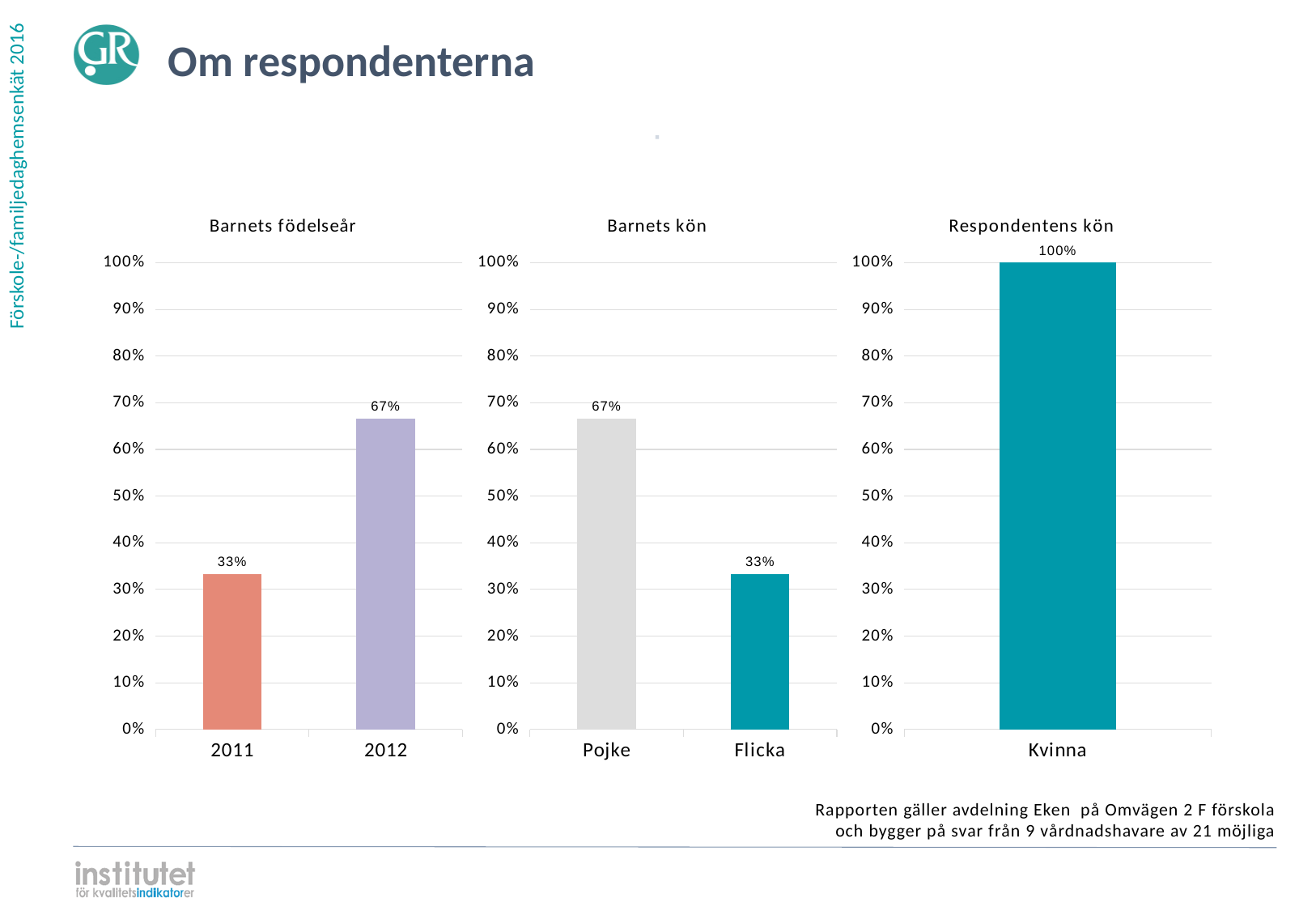
In the 'Barnets födelseår' chart, what is the value for 2012? 67% In the 'Barnets födelseår' chart, which category has the highest value? 2012 How many categories are shown in the 'Barnets födelseår' chart? 2 In the 'Barnets födelseår' chart, what is the difference between the values for 2012 and 2011? 34% What kind of chart is the 'Barnets kön' chart? Bar chart In the 'Barnets kön' chart, which category has the lowest value? Flicka In the 'Barnets kön' chart, which is larger, the value for Pojke or for Flicka? Pojke In the 'Respondentens kön' chart, what is the value for Kvinna? 100% In the 'Barnets födelseår' chart, what is the value for 2011? 33% How many categories are shown in the 'Respondentens kön' chart? 1 In the 'Barnets kön' chart, what is the value for Pojke? 67% In the 'Barnets kön' chart, what is the value for Flicka? 33%